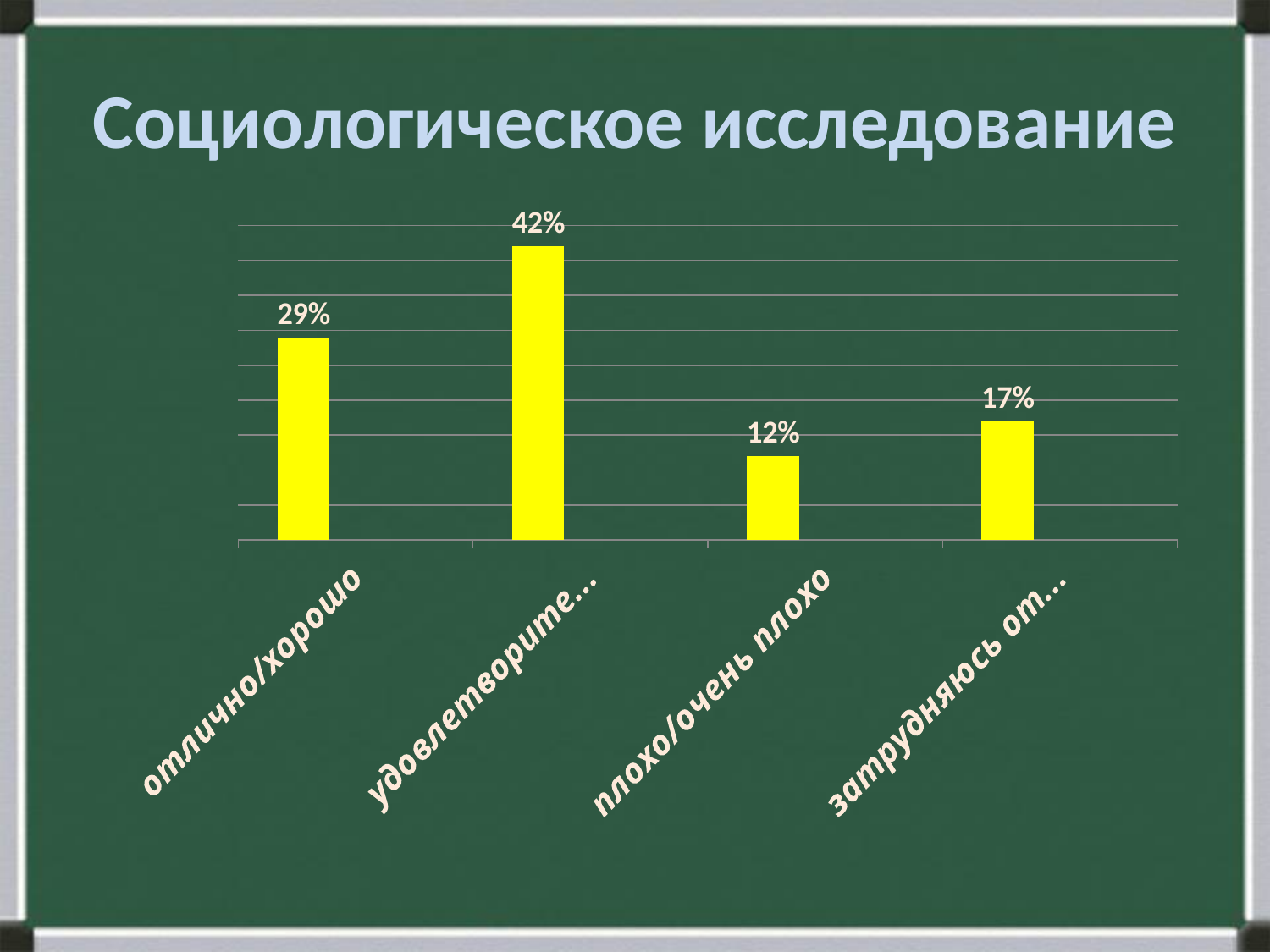
What is the value for the second category (удовлетворите...)? 42% How many categories are shown in the chart? 4 What is the title of the slide? Социологическое исследование What is the value for the last category (затрудняюсь от...)? 17% Which category has the lowest value? плохо/очень плохо What is the value for плохо/очень плохо? 12% What is the value for отлично/хорошо? 29% What is the difference between the values for затрудняюсь от... and плохо/очень плохо? 5% Which is larger, the value for отлично/хорошо or the value for затрудняюсь от...? отлично/хорошо Which category has the highest value? удовлетворите... What kind of chart is shown on the slide? bar chart What is the difference between the values for удовлетворите... and отлично/хорошо? 13%